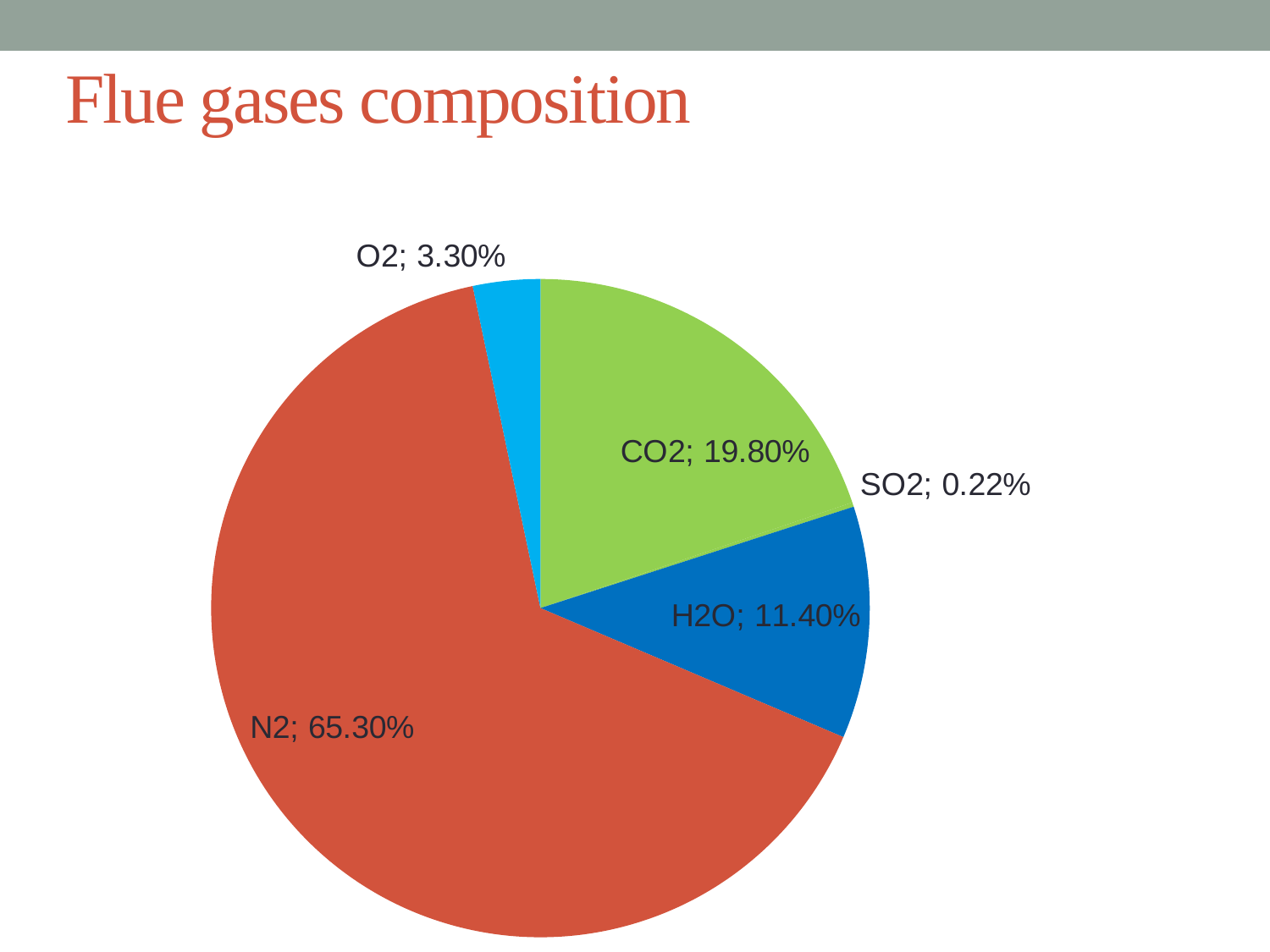
What is the value for N2? 65.30% Which gas has the largest share of the pie? N2 Which is larger, the value for O2 or the value for H2O? H2O What is the value for O2? 3.30% What is the value for SO2? 0.22% What is the difference between the values for CO2 and H2O? 8.40% What is the value for CO2? 19.80% How many slices does the pie chart have? 5 What is the title of the slide containing the chart? Flue gases composition What type of chart is shown on the slide? pie chart What is the value for H2O? 11.40% Which gas has the smallest share of the pie? SO2